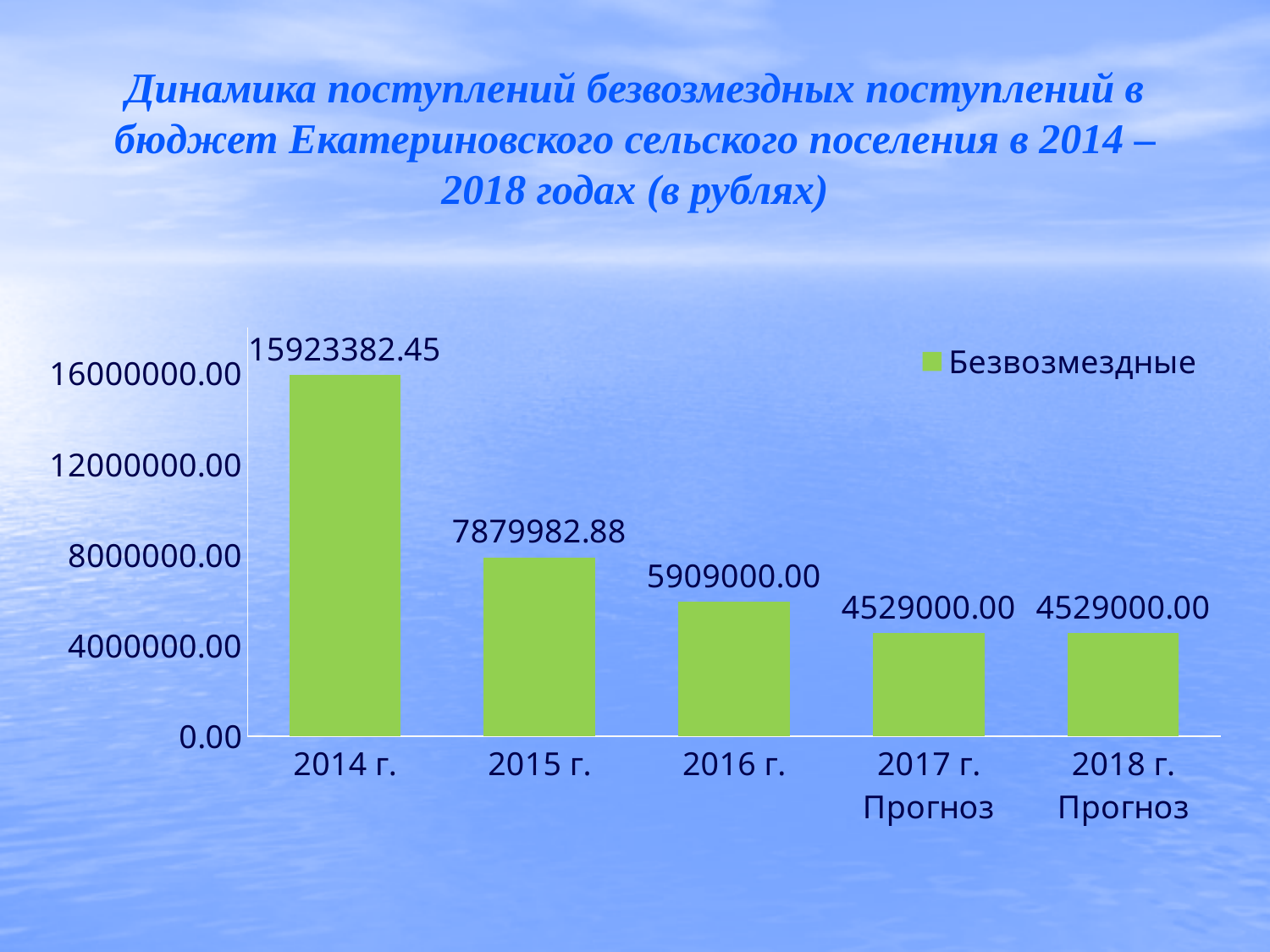
Which year has the highest value? 2014 г. How many categories are shown on the x axis? 5 Do the values rise or fall from 2014 г. to 2017 г. Прогноз? fall What is the value for 2014 г.? 15923382.45 What kind of chart is shown on the slide? bar chart Which is larger, the value for 2015 г. or the value for 2016 г.? 2015 г. Is the value for 2015 г. greater or less than 8000000.00? less What is the difference between the values for 2016 г. and 2017 г. Прогноз? 1380000.00 What is the value for 2015 г.? 7879982.88 What is the difference between the values for 2014 г. and 2015 г.? 8043399.57 What is the value for 2016 г.? 5909000.00 What is the value for 2017 г. Прогноз? 4529000.00